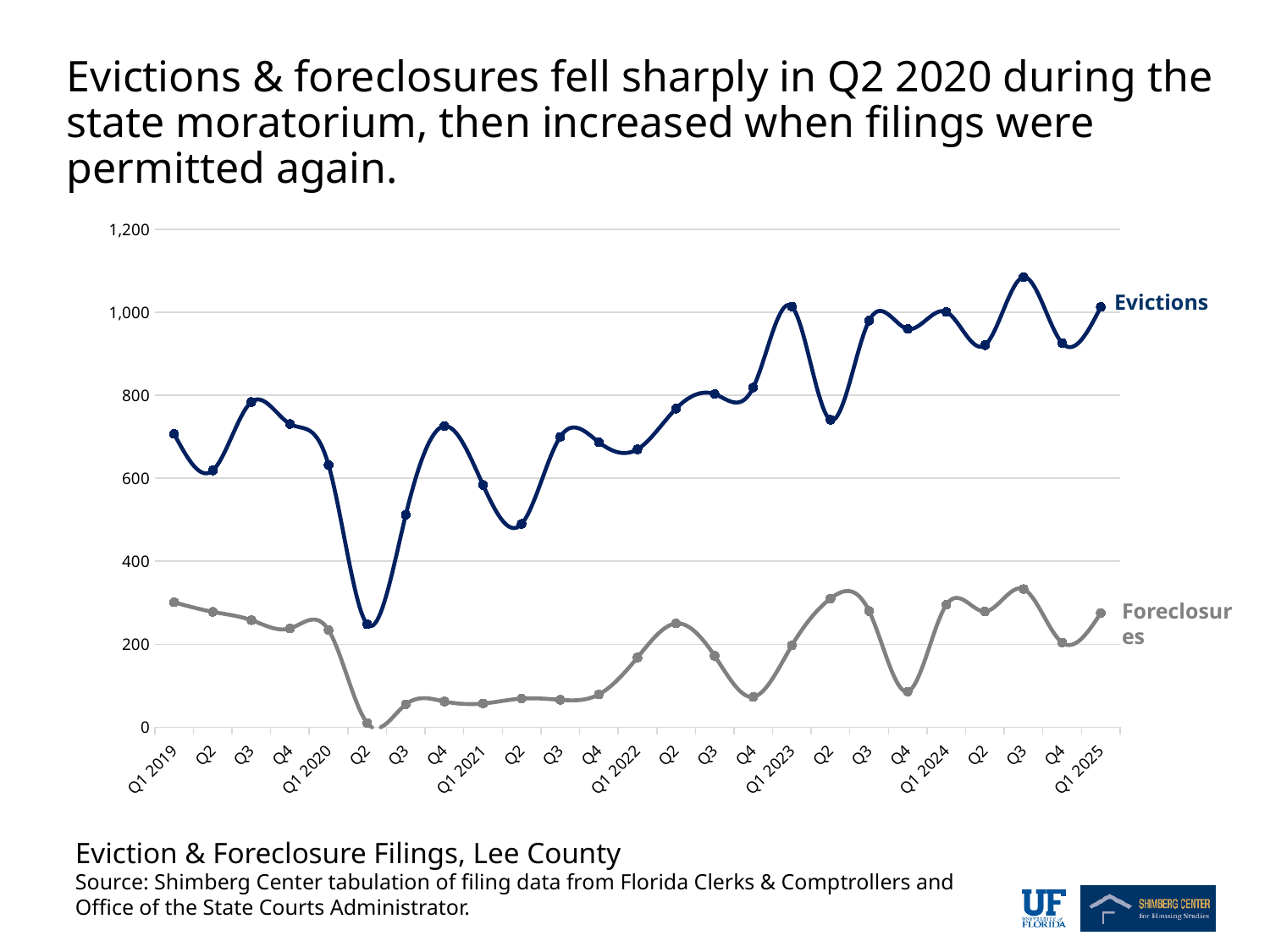
Overall, do Evictions rise or fall from Q1 2019 to Q1 2025? Rise How many series are plotted on the chart? 2 How many quarterly data points does each series have on the chart? 25 In which quarter is the Evictions series at its lowest? Q2 2020 Is the value for Evictions in Q2 2020 greater or less than 400? less In which quarter is the Foreclosures series at its lowest? Q2 2020 Is the value for Foreclosures in Q4 2023 greater or less than 200? less What are the names of the two series plotted on the chart? Evictions and Foreclosures Which series is higher in Q1 2025, Evictions or Foreclosures? Evictions What kind of chart is shown on the slide? Line chart Is the value for Evictions in Q3 2024 greater or less than 1,000? greater In which quarter is the Evictions series at its highest? Q3 2024